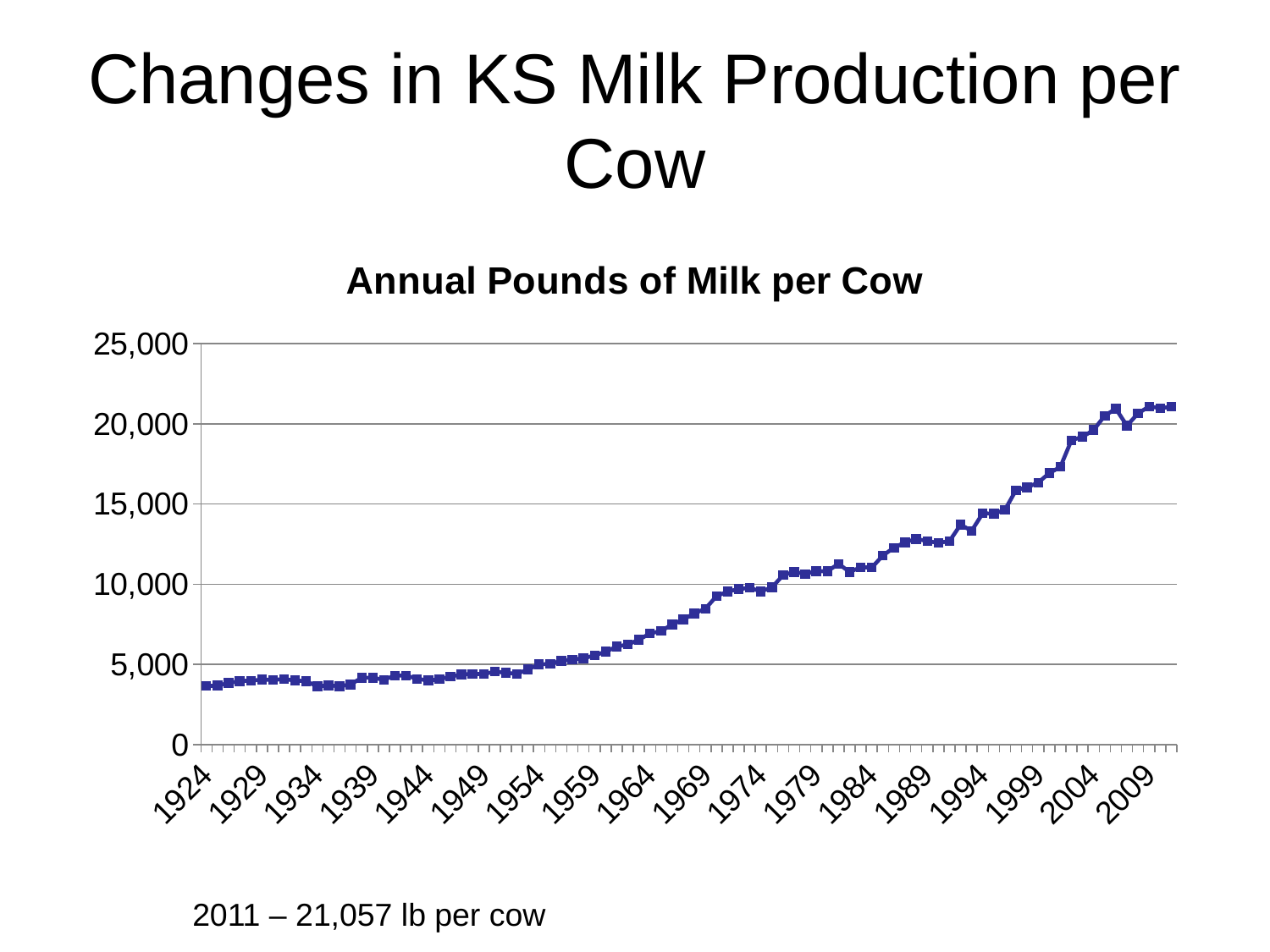
Is the value for 1924 greater or less than 5,000? less What is the title of the chart? Annual Pounds of Milk per Cow Which year has the larger value, 1924 or 2004? 2004 Is the value for 1989 greater or less than 10,000? greater Is the value for 1944 greater or less than 5,000? less What kind of chart is shown on the slide? line chart Do the values generally rise or fall from 1924 to 2009? rise Which year has the larger value, 1964 or 1994? 1994 What is the highest value shown on the vertical axis? 25,000